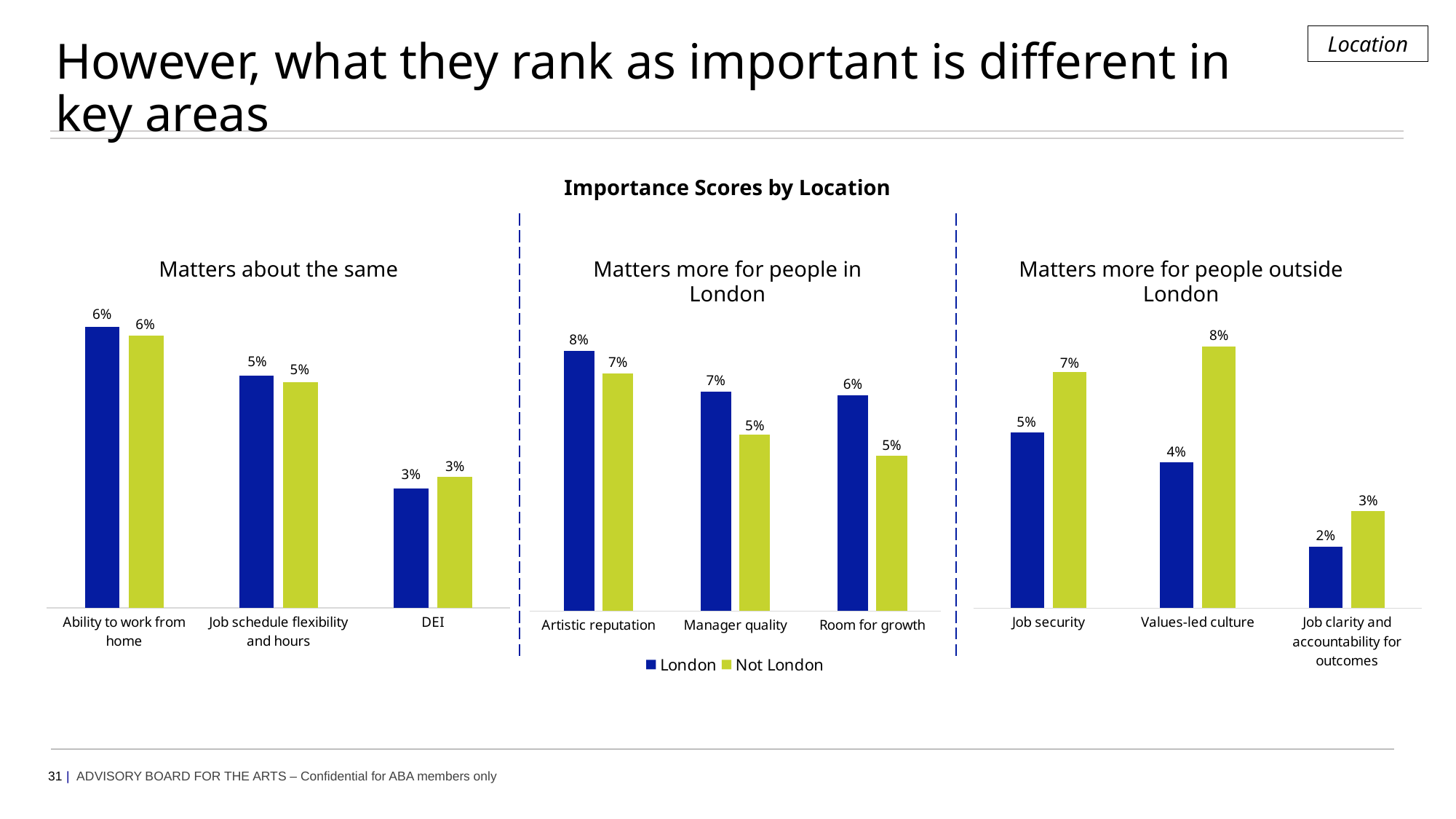
In the 'Matters more for people in London' chart, which category has the highest Not London value? Artistic reputation In the 'Matters more for people in London' chart, what is the London value for Artistic reputation? 8% How many series does the legend list? 2 How many categories are shown in the 'Matters about the same' chart? 3 What is the overall title above the three charts? Importance Scores by Location In the 'Matters about the same' chart, what is the London value for DEI? 3% In the 'Matters more for people outside London' chart, what is the difference between the Not London and London values for Values-led culture? 4% In the 'Matters more for people in London' chart, what is the difference between the London and Not London values for Manager quality? 2% What type of chart is the 'Matters more for people in London' chart? Bar chart In the 'Matters more for people outside London' chart, which category has the lowest London value? Job clarity and accountability for outcomes In the 'Matters more for people outside London' chart, what is the Not London value for Values-led culture? 8% In the 'Matters more for people outside London' chart, is the London or Not London value larger for Job security? Not London